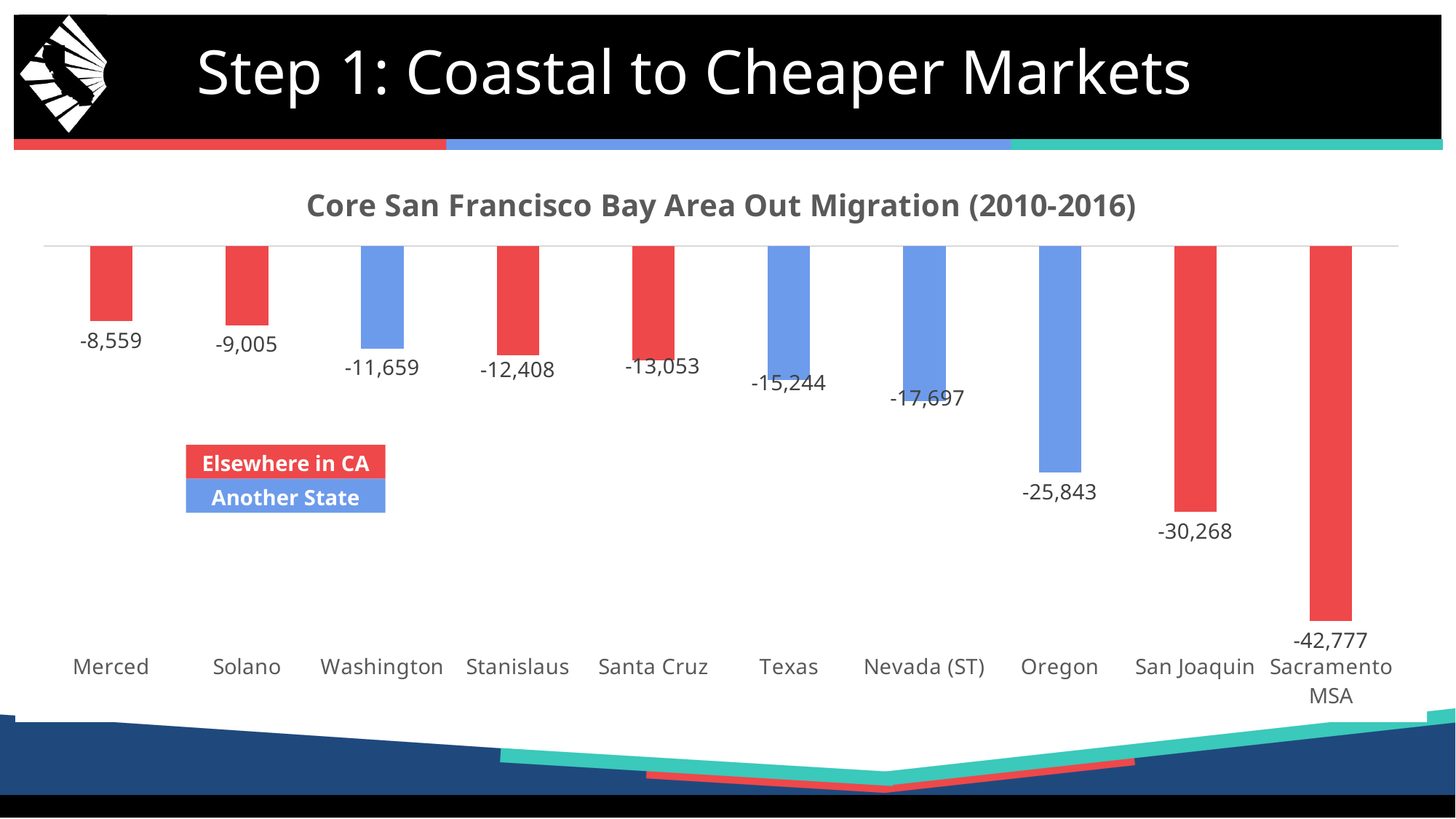
What kind of chart is shown on the slide? Bar chart What is the difference between the values for Oregon and Texas? 10,599 What is the value shown for Sacramento MSA? -42,777 What is the value shown for Nevada (ST)? -17,697 How many categories are shown on the x axis? 10 Which category has the largest out-migration (the most negative value)? Sacramento MSA What is the value shown for Oregon? -25,843 How many series does the legend list? 2 Which category has the smallest out-migration (the value closest to zero)? Merced What is the value shown for Merced? -8,559 Which has the larger out-migration, Oregon or Texas? Oregon What is the difference between the values for Sacramento MSA and San Joaquin? 12,509